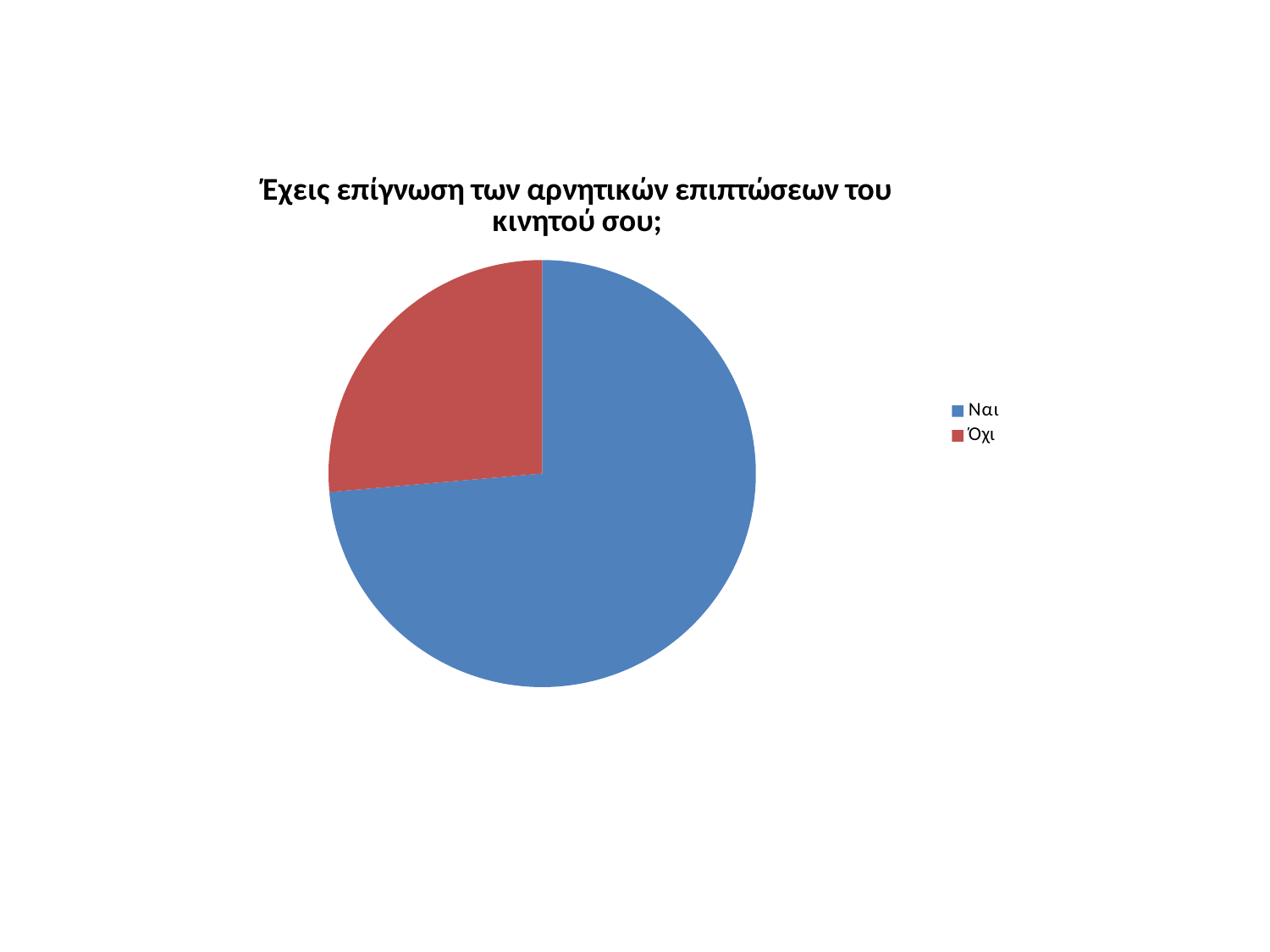
Which category has the largest slice of the pie? Ναι What kind of chart is shown on the slide? pie chart How many entries does the legend list? 2 What is the title of the chart? Έχεις επίγνωση των αρνητικών επιπτώσεων του κινητού σου; Which category has the smallest slice of the pie? Όχι How many slices does the pie chart have? 2 Which slice is larger, Ναι or Όχι? Ναι What colour is the slice for Όχι? red